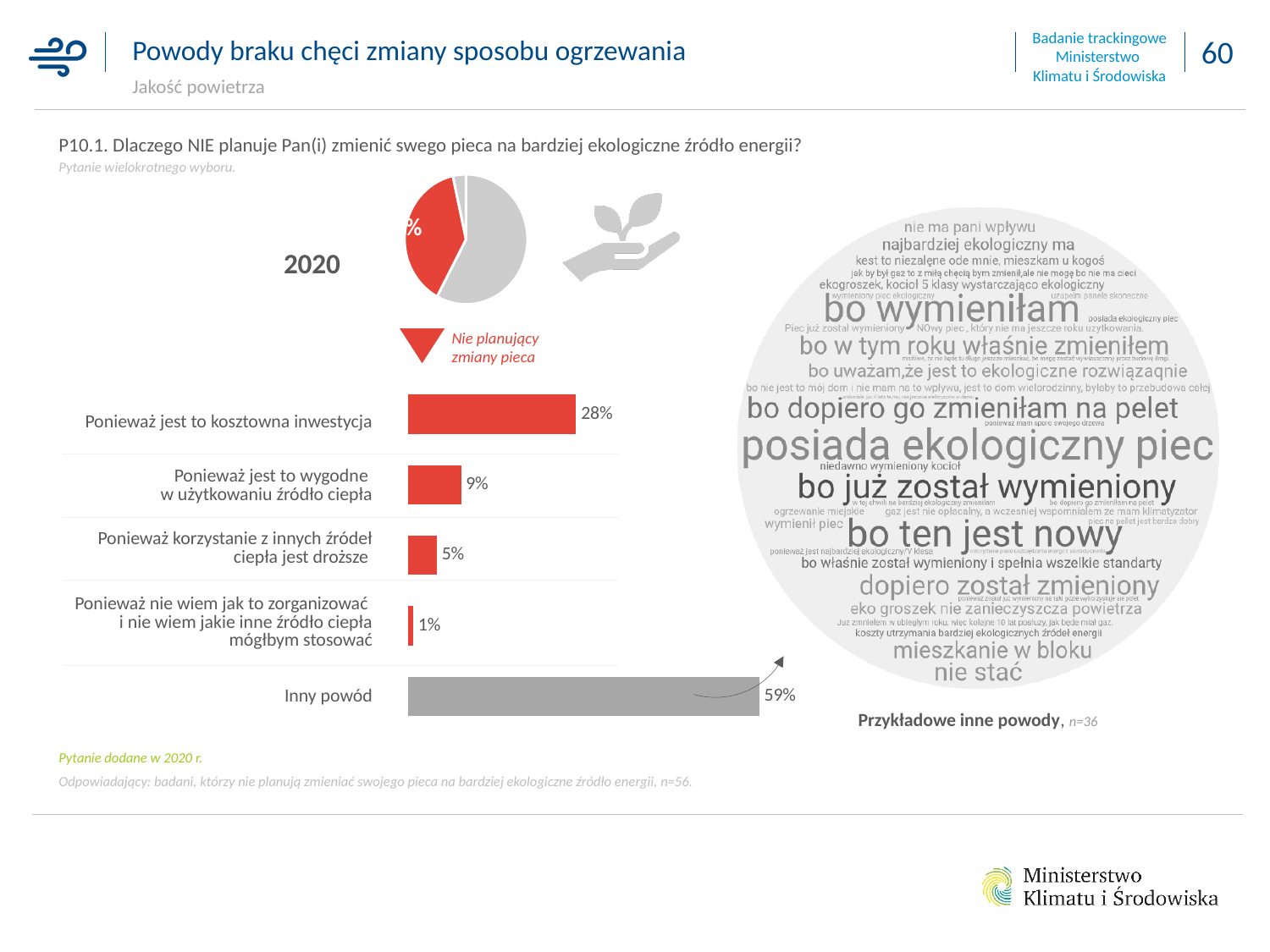
What label is shown in the legend next to the red triangle marker above the bar chart? Nie planujący zmiany pieca What kind of chart is the chart on the left showing the year 2020? Pie chart In the bar chart, what is the value for "Ponieważ jest to wygodne w użytkowaniu źródło ciepła"? 9% In the bar chart, what is the difference between the values for "Inny powód" and "Ponieważ jest to kosztowna inwestycja"? 31% In the bar chart, which category has the lowest value? Ponieważ nie wiem jak to zorganizować i nie wiem jakie inne źródło ciepła mógłbym stosować In the bar chart, which category has the highest value? Inny powód In the bar chart, what is the value for "Ponieważ jest to kosztowna inwestycja"? 28% How many categories are shown in the bar chart? 5 In the bar chart, what is the value for "Ponieważ korzystanie z innych źródeł ciepła jest droższe"? 5% In the bar chart, which is larger: the value for "Ponieważ jest to kosztowna inwestycja" or the value for "Ponieważ jest to wygodne w użytkowaniu źródło ciepła"? Ponieważ jest to kosztowna inwestycja In the bar chart, what is the difference between the values for "Ponieważ jest to wygodne w użytkowaniu źródło ciepła" and "Ponieważ korzystanie z innych źródeł ciepła jest droższe"? 4% In the bar chart, what is the value for "Inny powód"? 59%